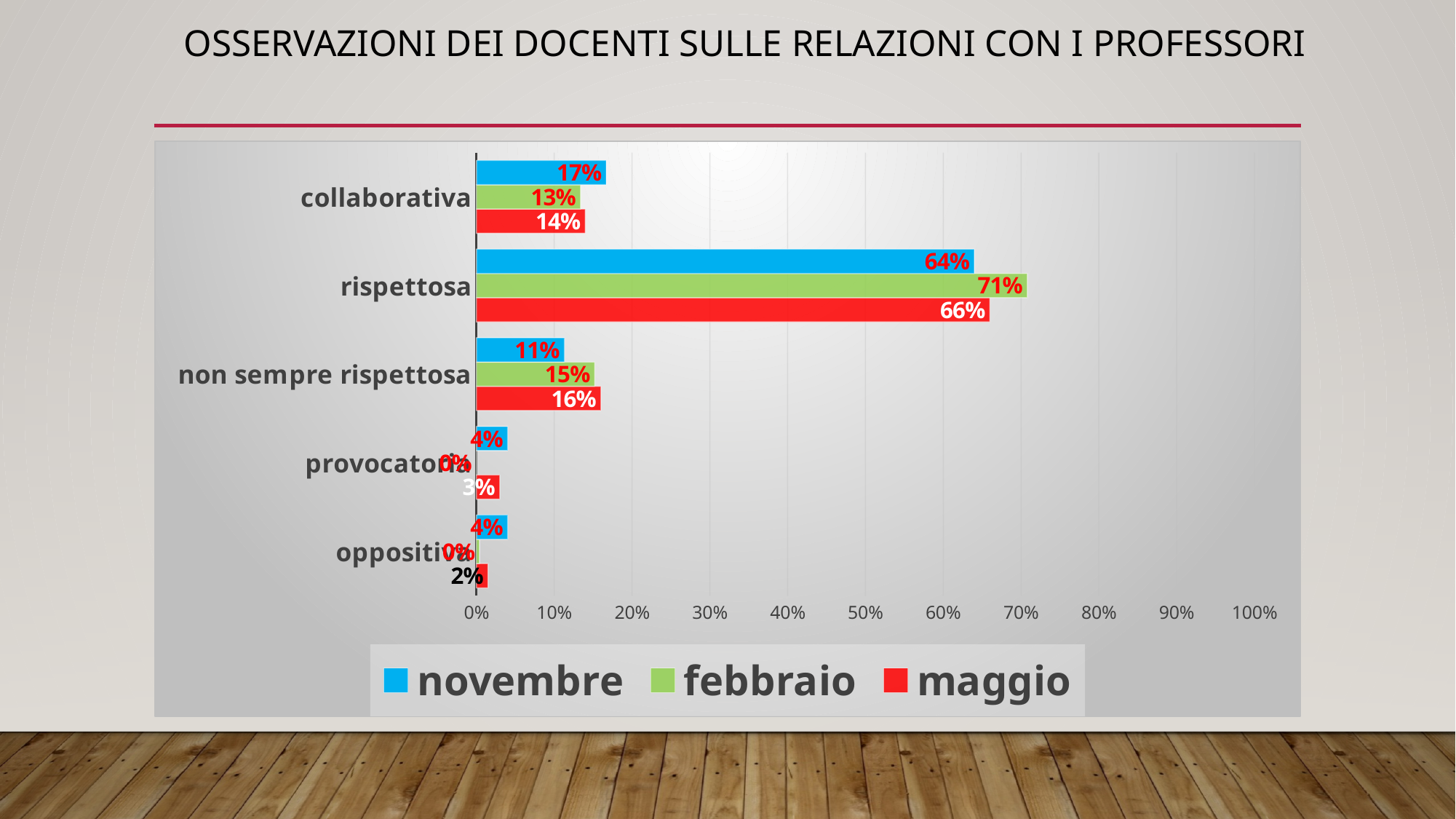
How many series does the legend list? 3 What is the difference between the febbraio and novembre values for 'rispettosa'? 7% Which series is shown in red in the legend? maggio What is the value for 'collaborativa' in the novembre series? 17% What is the difference between the maggio and novembre values for 'non sempre rispettosa'? 5% How many categories are shown on the chart? 5 What is the value for 'rispettosa' in the febbraio series? 71% Which is larger for 'collaborativa': the novembre value or the febbraio value? novembre Is the maggio value for 'rispettosa' greater or less than 60%? greater What type of chart is shown on the slide? bar chart Which category has the highest value in the novembre series? rispettosa What is the value for 'non sempre rispettosa' in the maggio series? 16%